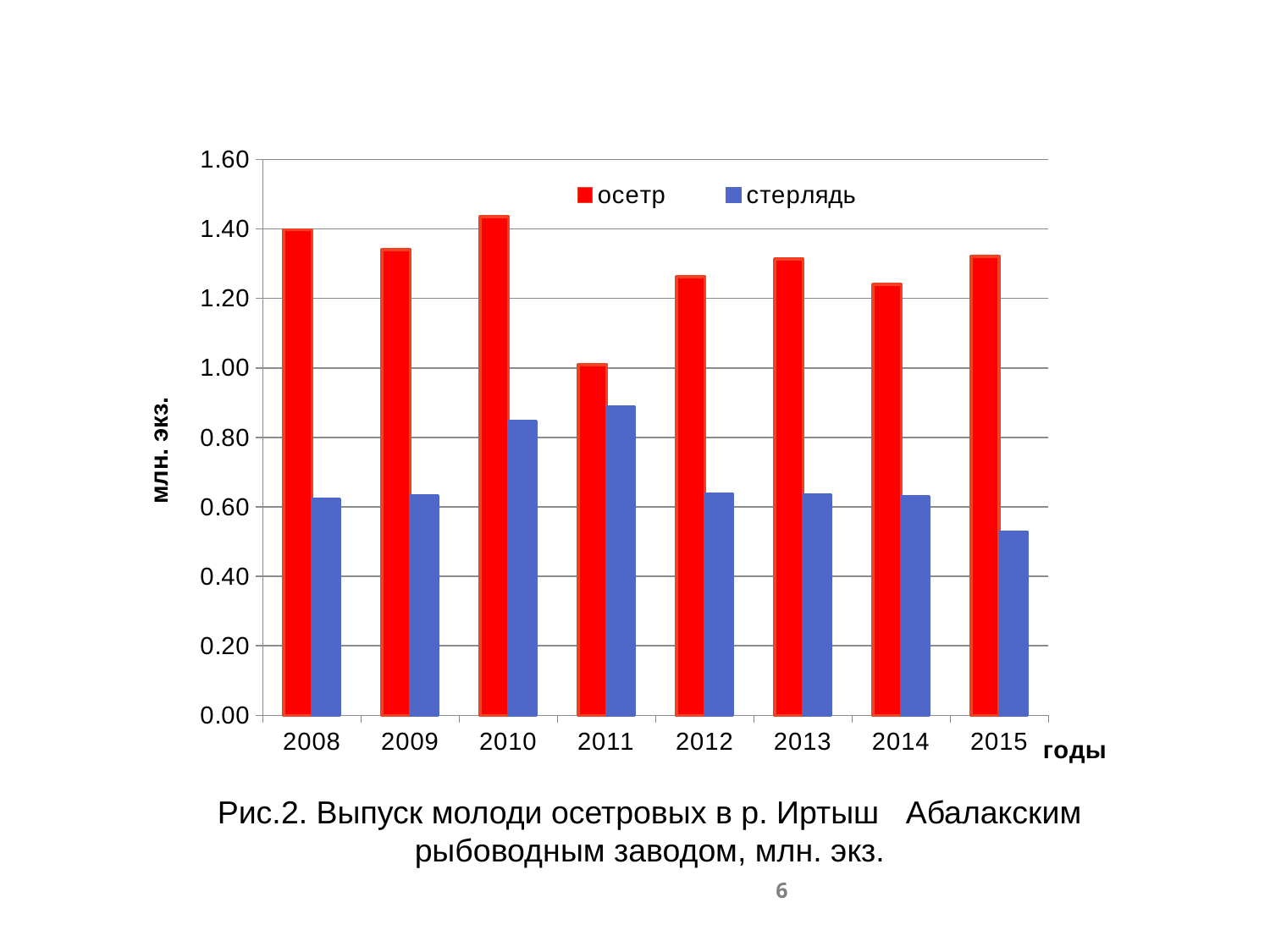
What kind of chart is shown on the slide? bar chart Is the value for стерлядь in 2015 greater or less than 0.60? less How many years are shown on the x axis? 8 Is the value for стерлядь in 2010 greater or less than 0.80? greater In which year is the value for осетр the highest? 2010 Is the value for осетр in 2008 greater or less than 1.20? greater Which is larger: the value for осетр in 2008 or in 2011? 2008 In which year is the value for осетр the lowest? 2011 In which year is the value for стерлядь the lowest? 2015 What is the label on the y axis? млн. экз. How many series does the legend list? 2